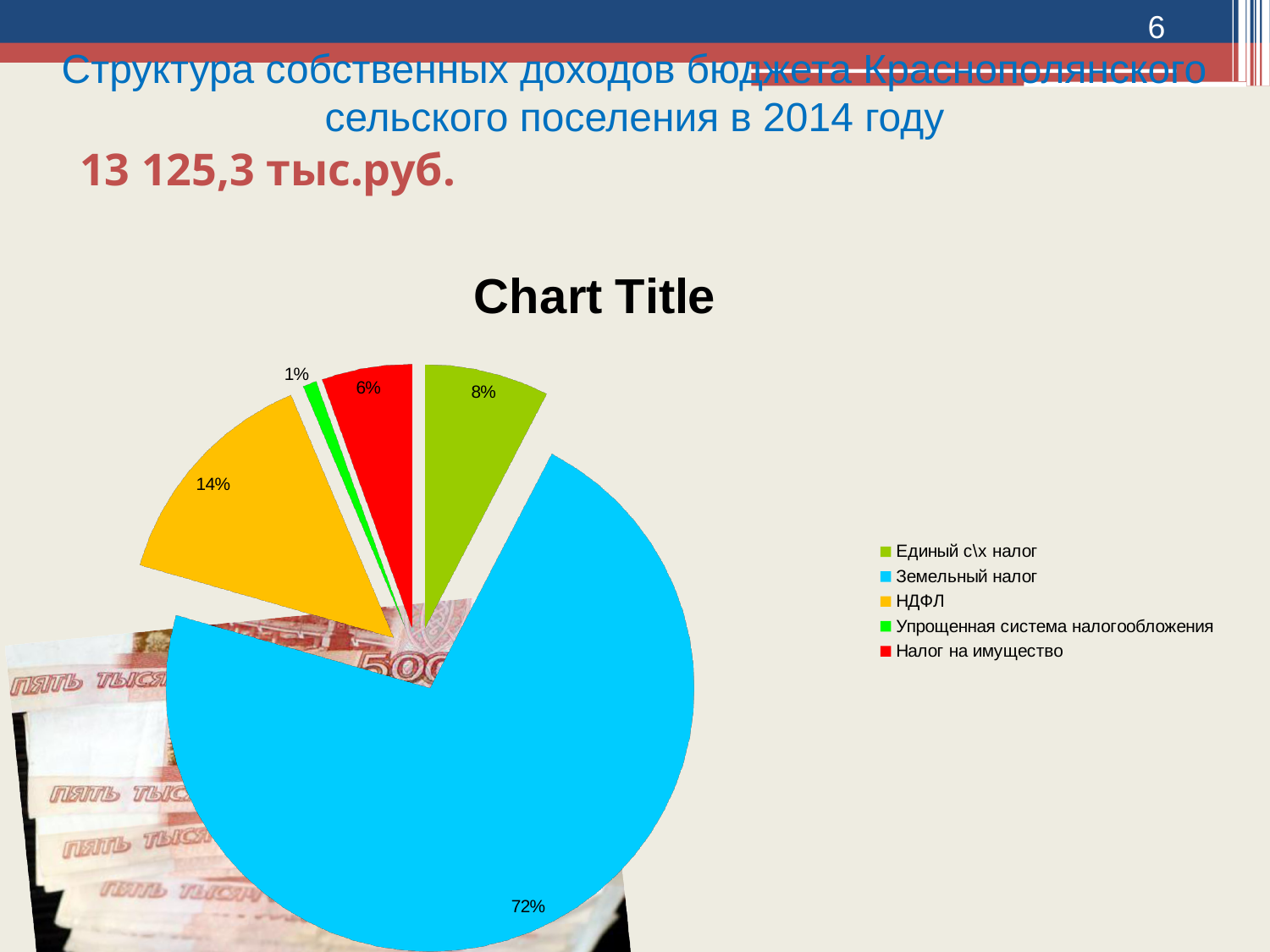
Which is larger, the share for НДФЛ or the share for Единый с\х налог? НДФЛ What is the difference in percentage points between Земельный налог and НДФЛ? 58 What share of the pie does НДФЛ have? 14% Which category has the largest slice of the pie? Земельный налог How many categories does the pie chart have? 5 What share of the pie does Единый с\х налог have? 8% Which category has the smallest slice of the pie? Упрощенная система налогообложения What share of the pie does Упрощенная система налогообложения have? 1% What kind of chart is shown on the slide? pie chart What colour is the slice for Налог на имущество? red